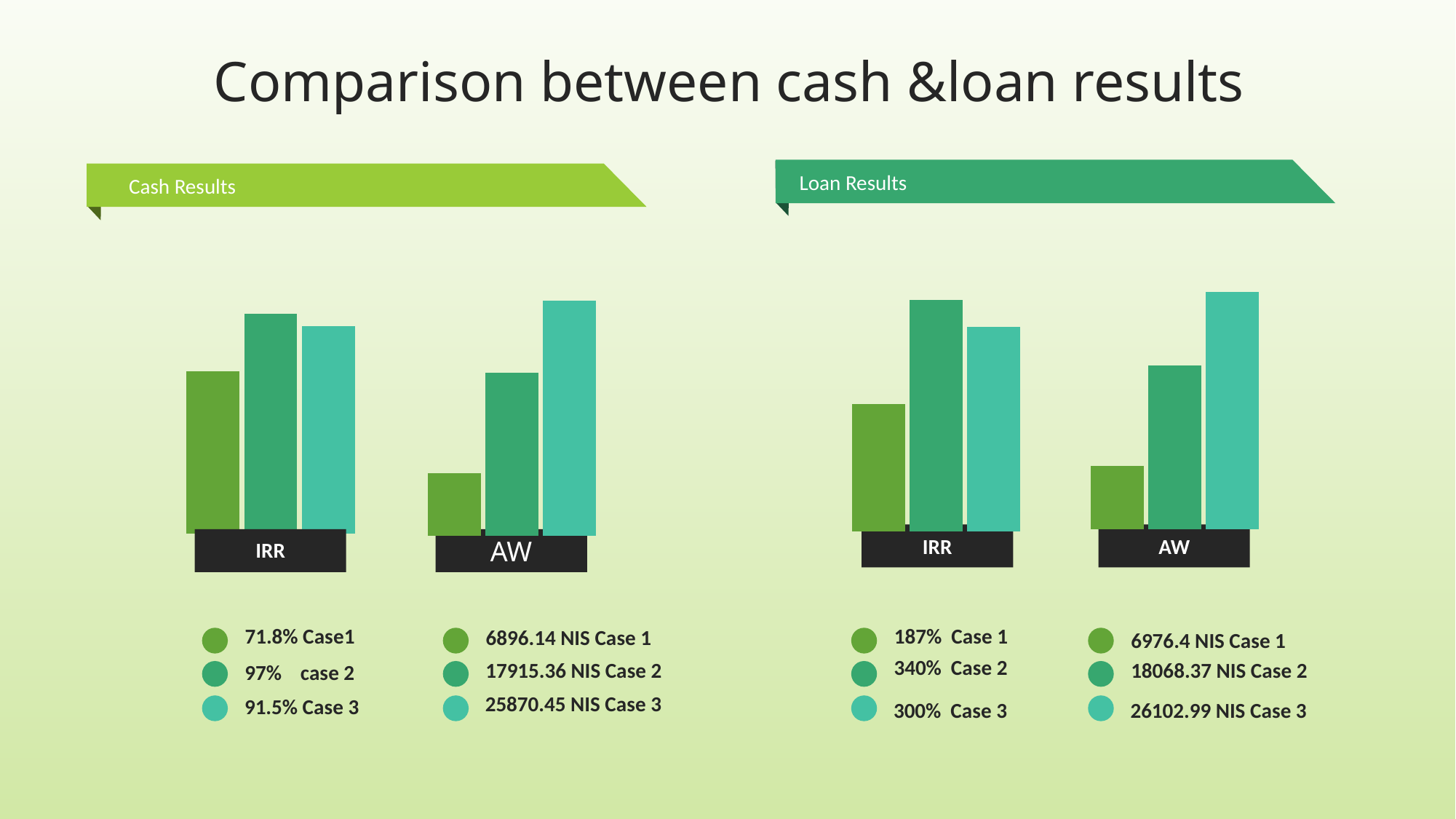
In the Loan Results chart, what is the IRR value for Case 2? 340% What kind of chart is used in the Loan Results section? Bar chart How many cases are shown in each bar group on the slide? 3 In the Cash Results chart, what is the AW value for Case 3? 25870.45 NIS Which is larger: the Cash Results IRR for Case 3 or the Cash Results IRR for Case 1? Case 3 In the Cash Results chart, which case has the highest IRR? case 2 In the Cash Results chart, what is the difference between the AW of Case 2 and Case 1? 11019.22 NIS What is the title of the slide? Comparison between cash &loan results In the Loan Results chart, what is the AW value for Case 1? 6976.4 NIS In the Loan Results chart, which case has the lowest AW? Case 1 In the Cash Results chart, what is the IRR value for Case 1? 71.8% In the Loan Results chart, what is the difference between the IRR of Case 2 and Case 3? 40%